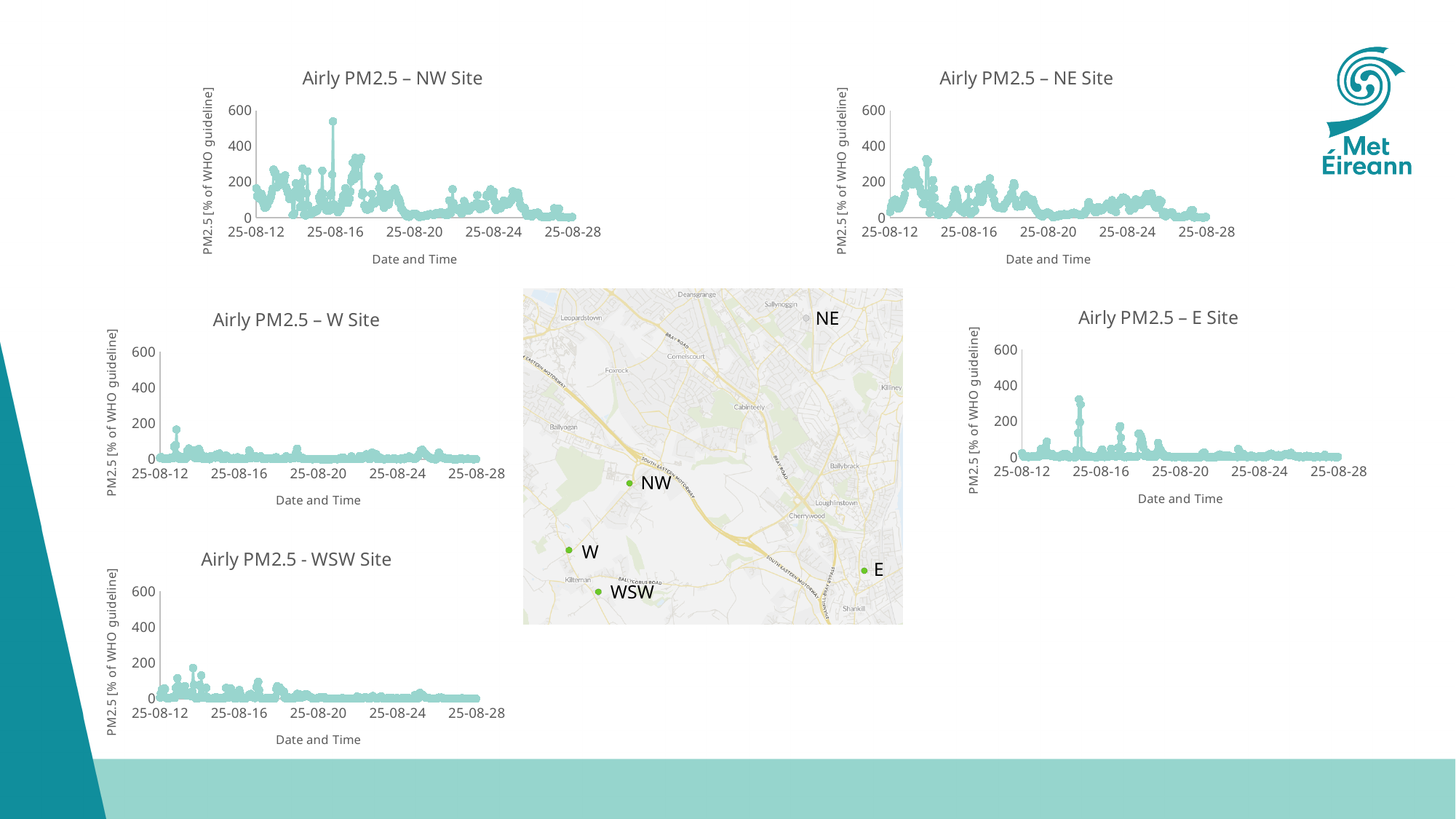
In the "Airly PM2.5 - WSW Site" chart, is the highest peak value greater or less than 400? less In the "Airly PM2.5 – NW Site" chart, what is the first date label shown on the x axis? 25-08-12 What is the y-axis title of the "Airly PM2.5 – W Site" chart? PM2.5 [% of WHO guideline] What is the highest tick value shown on the y axis of the "Airly PM2.5 – E Site" chart? 600 In the "Airly PM2.5 – E Site" chart, is the highest peak value greater or less than 200? greater In the "Airly PM2.5 – NE Site" chart, do the values generally rise or fall from 25-08-12 to 25-08-28? fall In the "Airly PM2.5 – W Site" chart, is the highest peak value greater or less than 400? less How many PM2.5 charts are shown on the slide? 5 Which chart has the higher peak value, "Airly PM2.5 – NW Site" or "Airly PM2.5 – W Site"? Airly PM2.5 – NW Site What kind of chart is the "Airly PM2.5 – NW Site" chart? scatter chart